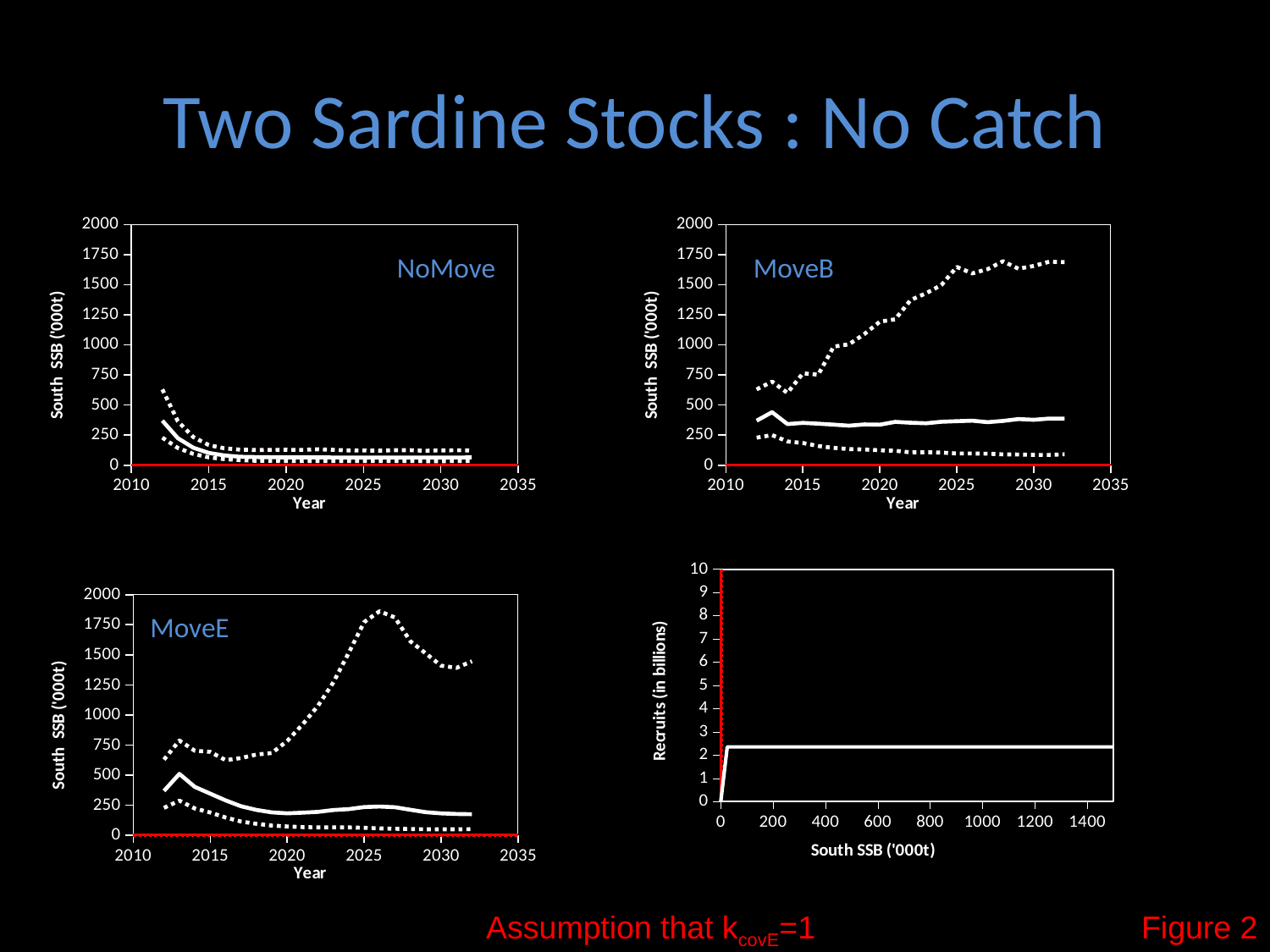
In the MoveB chart, does the upper dotted line rise or fall from 2012 to 2032? rise Is the peak of the upper dotted line higher in the MoveE chart or the MoveB chart? MoveE How many lines are plotted in the MoveE chart? 3 In the MoveB chart, is the value of the upper dotted line in 2030 greater or less than 1500? greater What is the x-axis label of the bottom-right chart? South SSB ('000t) In the NoMove chart, is the value of the solid line in 2030 greater or less than 250? less In the bottom-right chart, is the number of recruits at a South SSB of 1000 greater or less than 5? less What kind of chart is the NoMove chart? line chart In the NoMove chart, does the solid line rise or fall from 2012 to 2032? fall What is the y-axis label of the bottom-right chart? Recruits (in billions)